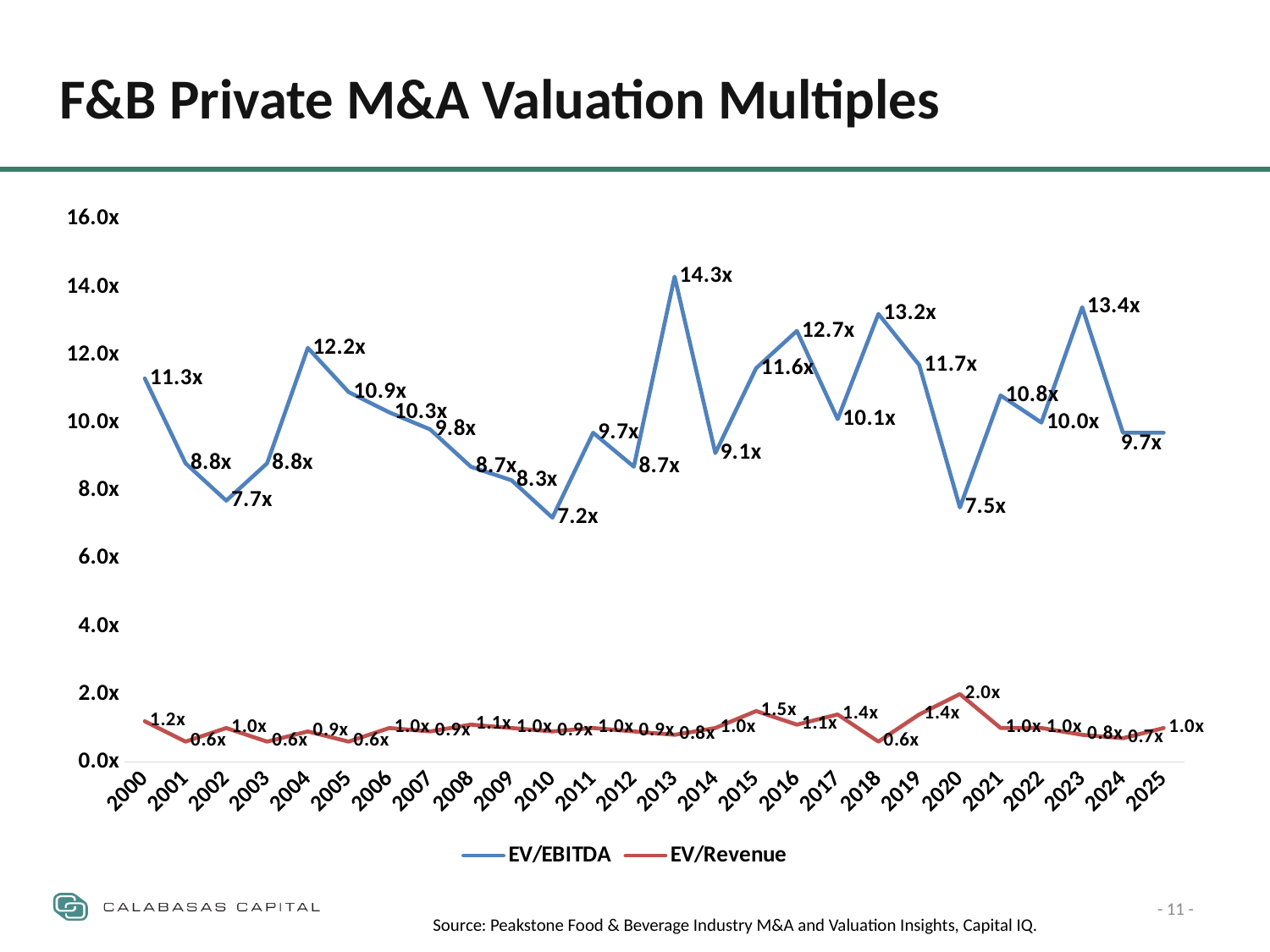
Which year has the larger EV/EBITDA multiple, 2016 or 2018? 2018 How many series does the legend list? 2 In which year is the EV/Revenue multiple highest? 2020 Does the EV/EBITDA multiple rise or fall from 2000 to 2002? Fall What is the EV/Revenue multiple for 2020? 2.0x What is the difference between the EV/EBITDA multiple in 2023 and in 2020? 5.9x In which year is the EV/EBITDA multiple highest? 2013 What is the EV/EBITDA multiple for 2013? 14.3x What is the EV/EBITDA multiple for 2004? 12.2x How many years are plotted on the x axis? 26 In which year is the EV/EBITDA multiple lowest? 2010 What kind of chart is shown on the slide? Line chart